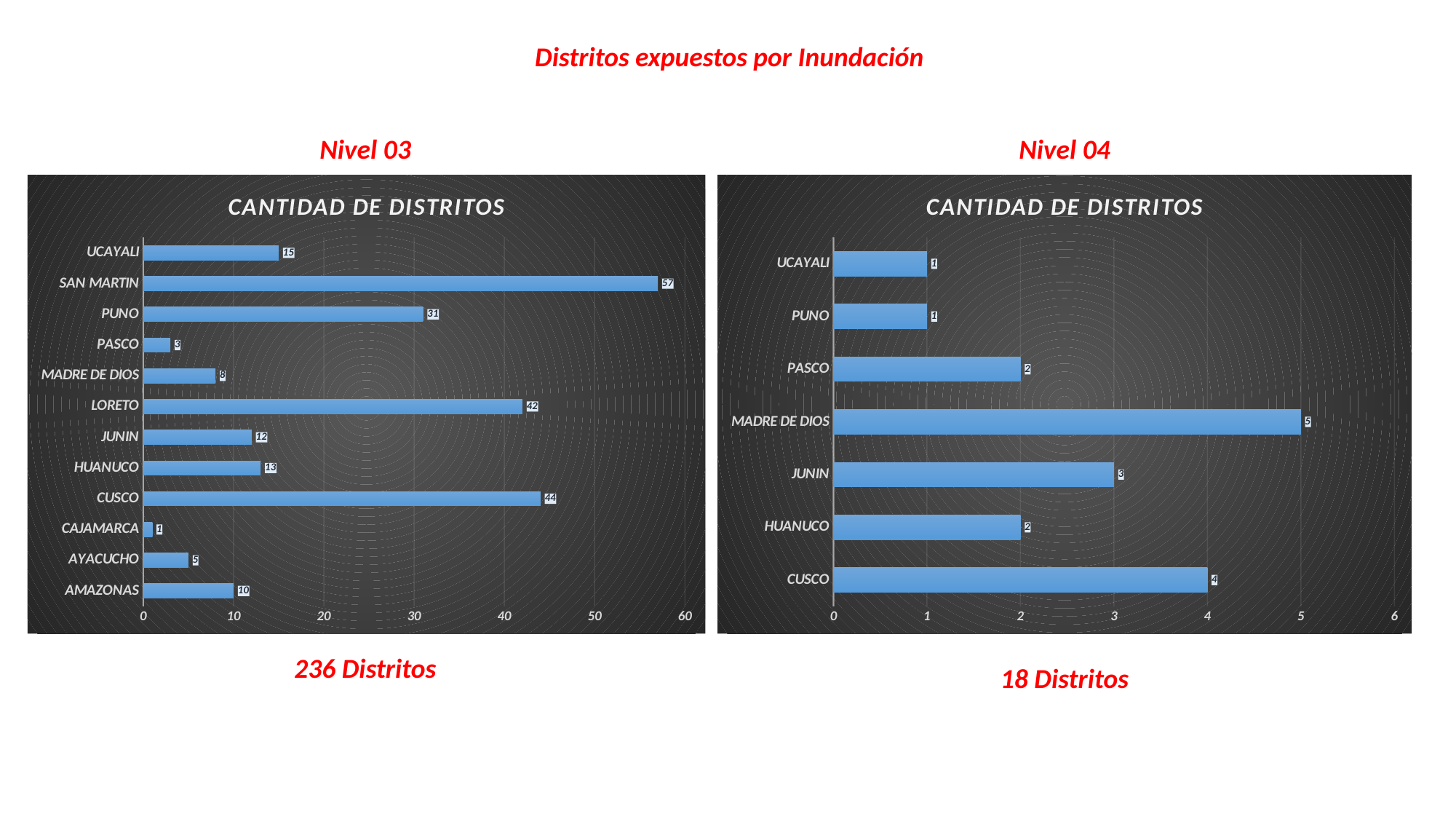
In the Nivel 04 chart, what is the difference between the values for CUSCO and JUNIN? 1 In the Nivel 03 chart, what is the difference between the values for CUSCO and LORETO? 2 In the Nivel 03 chart, what is the value for SAN MARTIN? 57 What is the title shown inside the Nivel 03 chart? CANTIDAD DE DISTRITOS In the Nivel 04 chart, which category has the highest value? MADRE DE DIOS In the Nivel 03 chart, which category has the lowest value? CAJAMARCA In the Nivel 04 chart, what is the value for MADRE DE DIOS? 5 In the Nivel 03 chart, which is larger, the value for PUNO or the value for UCAYALI? PUNO In the Nivel 03 chart, which category has the highest value? SAN MARTIN In the Nivel 03 chart, how many categories are shown? 12 What kind of chart is the Nivel 04 chart? Bar chart In the Nivel 04 chart, how many categories are shown? 7